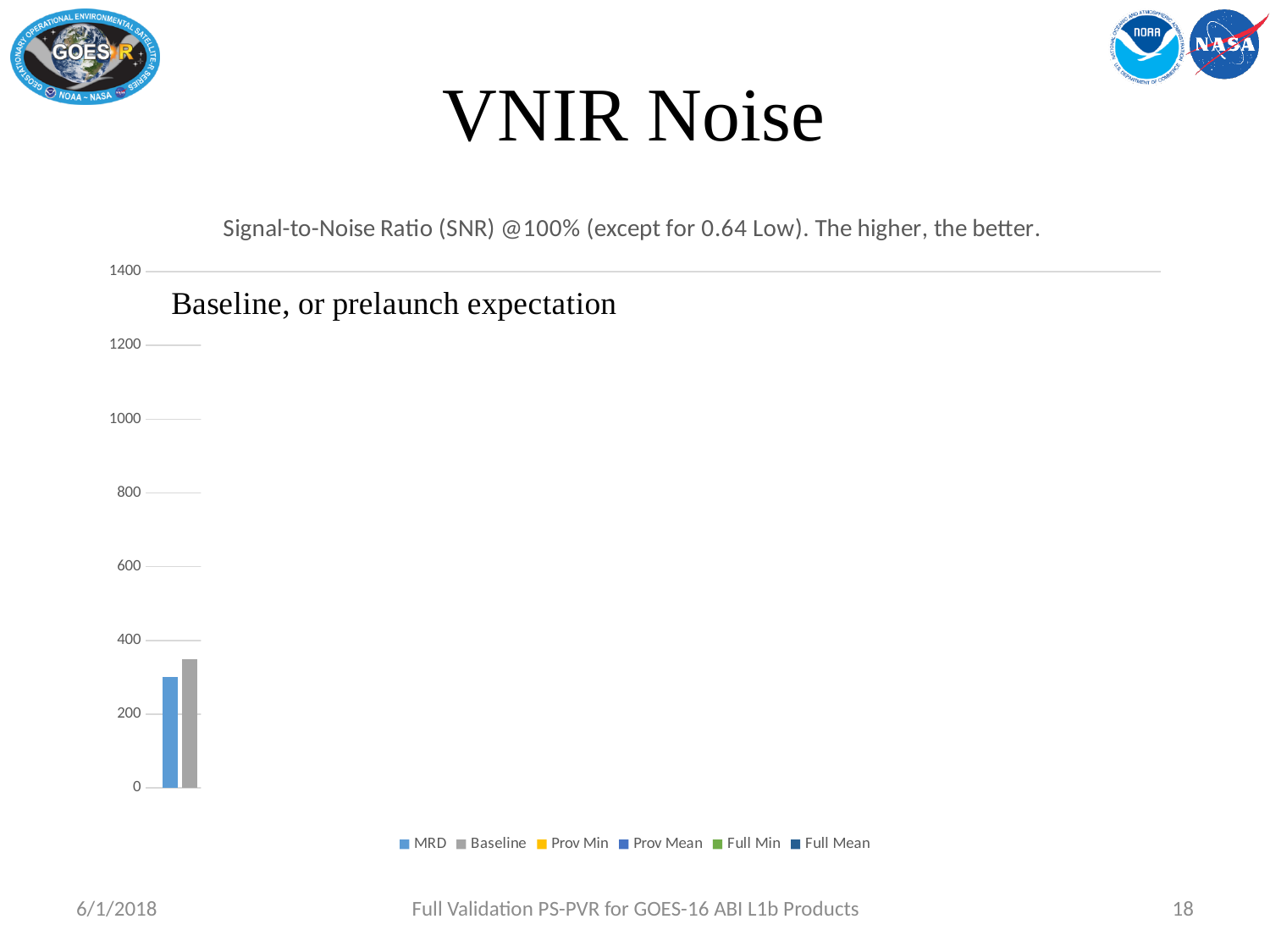
What is the highest value shown on the vertical axis? 1400 What is the title of the chart? Signal-to-Noise Ratio (SNR) @100% (except for 0.64 Low). The higher, the better. How many series does the chart's legend list? 6 Which series is shown in grey in the legend? Baseline Is the value of the MRD bar greater or less than 400? less Is the value of the MRD bar greater or less than 200? greater What kind of chart is shown on the slide? bar chart Is the value of the Baseline bar greater or less than 400? less How many bars are plotted on the chart? 2 Which bar is taller, MRD or Baseline? Baseline